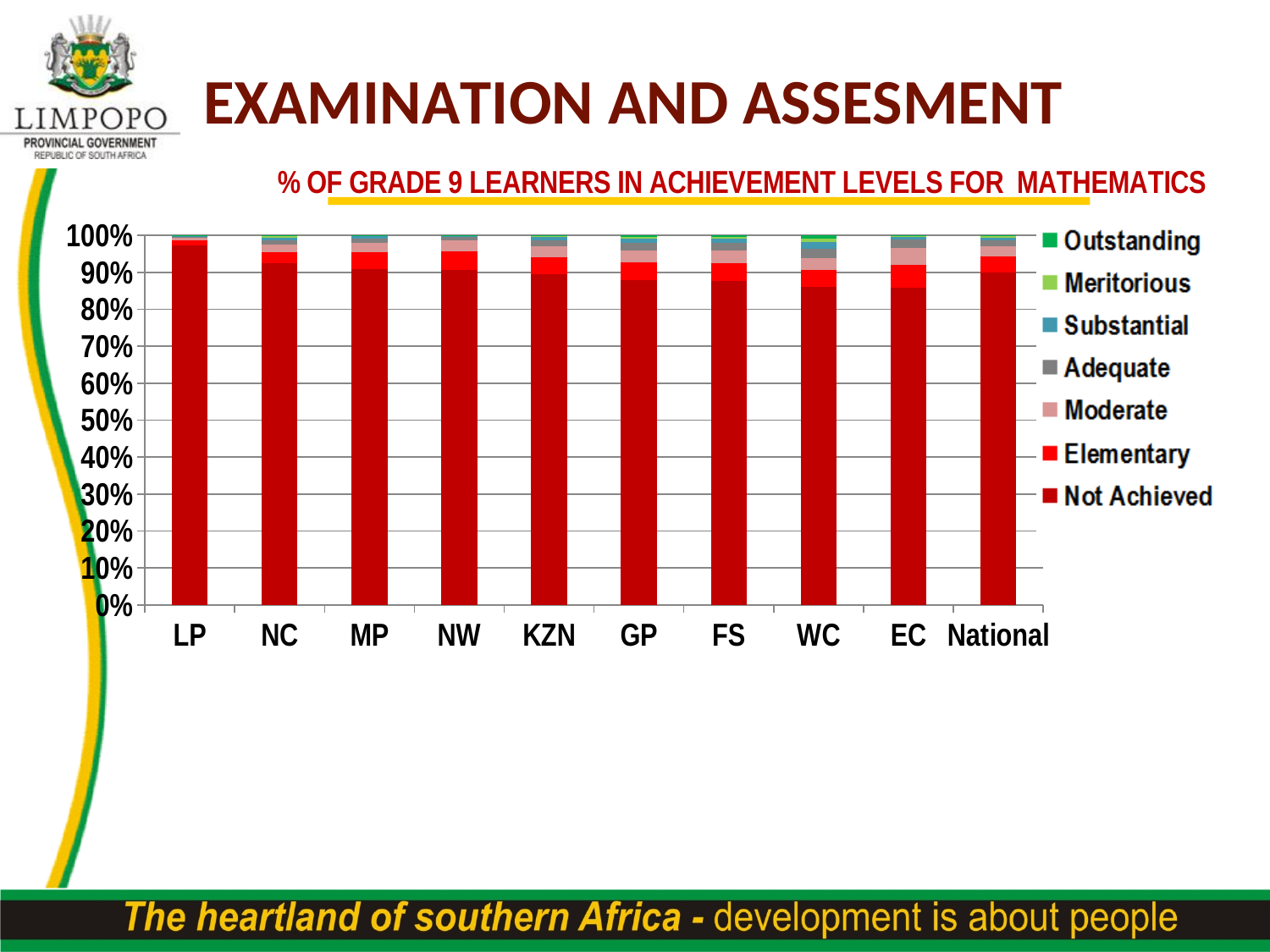
How many categories are shown along the x axis of the chart? 10 What does each stacked bar in the chart total? 100% Is the Not Achieved share for EC greater or less than 90%? less Is the Not Achieved share for WC greater or less than 90%? less Which category has the highest share of learners in the Not Achieved level? LP Which series is listed last in the chart's legend? Not Achieved How many series does the chart's legend list? 7 Which has a larger Not Achieved share, LP or WC? LP What is the title of the chart? % OF GRADE 9 LEARNERS IN ACHIEVEMENT LEVELS FOR MATHEMATICS What kind of chart is shown on the slide? Stacked bar chart Which has a larger Not Achieved share, NC or EC? NC Is the Not Achieved share for LP greater or less than 90%? greater